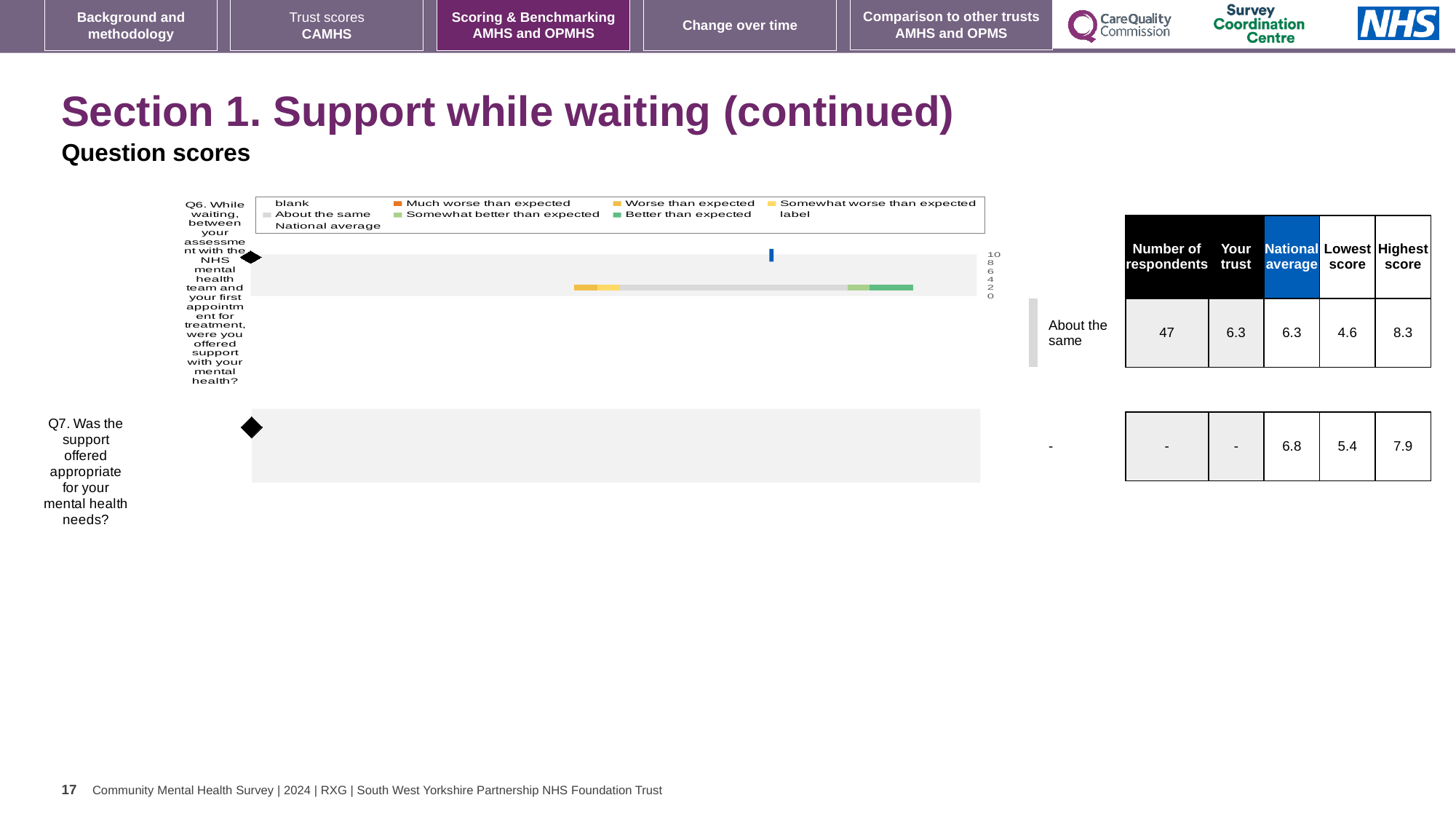
What is the difference between the highest and lowest scores for Q6? 3.7 What is the national average score for Q6? 6.3 What is the number of respondents for Q6? 47 Which is larger, the highest score for Q6 or the highest score for Q7? Q6 (8.3) What kind of chart is used for Q6 on this slide? bar chart What is the highest score for Q6? 8.3 What is the lowest score for Q7? 5.4 Which legend entry is shown in orange in the Q6 chart legend? Much worse than expected What is the 'Your trust' score for Q6? 6.3 What is the national average score for Q7? 6.8 What benchmark category is shown next to the Q6 chart? About the same How many entries does the legend above the Q6 chart list? 9